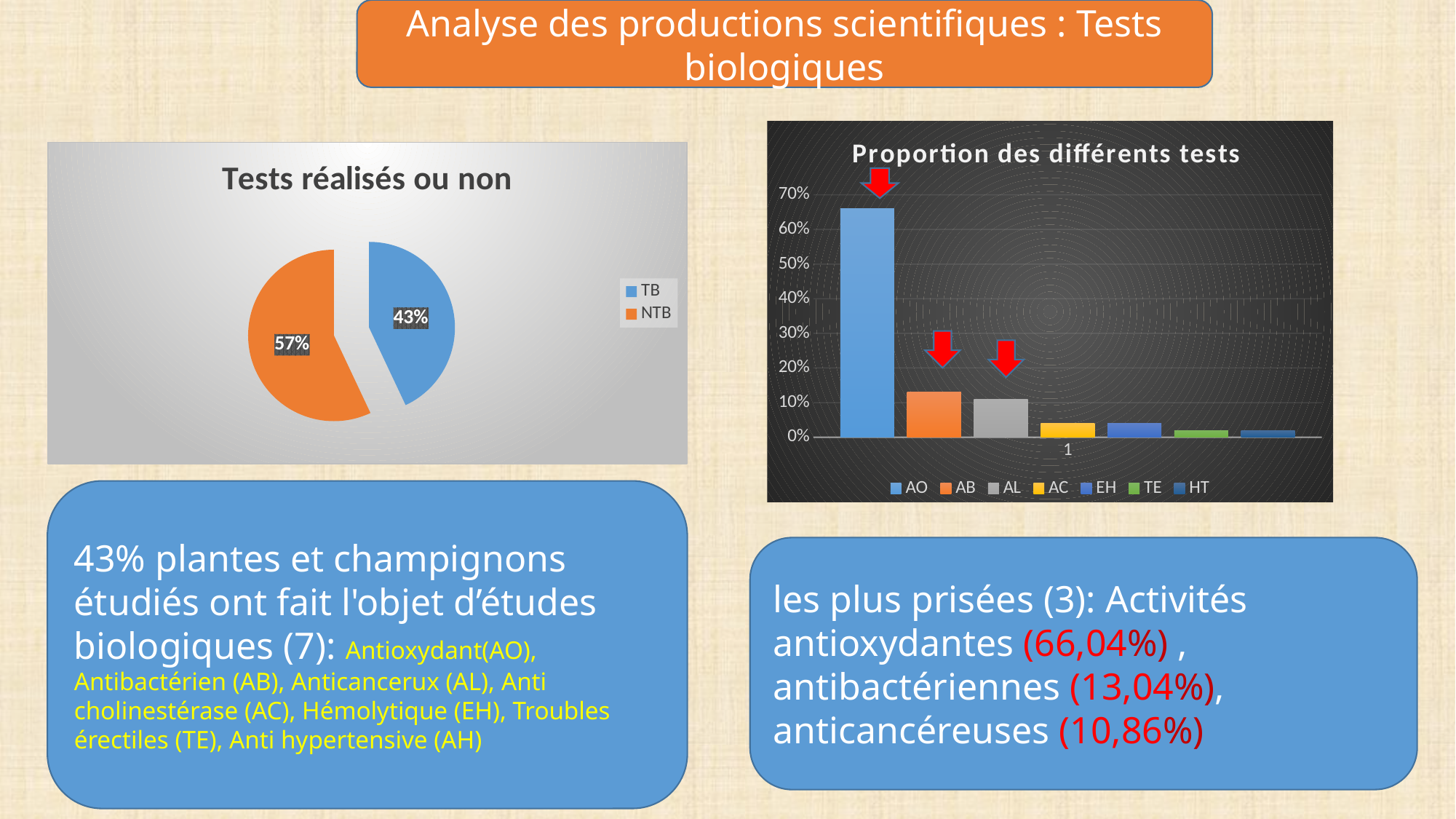
In the pie chart 'Tests réalisés ou non', how many slices does the pie have? 2 In the chart 'Proportion des différents tests', how many series does the legend list? 7 What kind of chart is 'Tests réalisés ou non'? pie chart In the pie chart 'Tests réalisés ou non', what percentage is shown for TB? 43% In the pie chart 'Tests réalisés ou non', what percentage is shown for NTB? 57% In the chart 'Proportion des différents tests', is the value for AO greater or less than 60%? greater In the chart 'Proportion des différents tests', which series has the highest value? AO What kind of chart is 'Proportion des différents tests'? bar chart In the pie chart 'Tests réalisés ou non', what is the difference in percentage points between NTB and TB? 14 In the pie chart 'Tests réalisés ou non', which slice is larger, TB or NTB? NTB In the chart 'Proportion des différents tests', is the value for AC greater or less than 10%? less In the chart 'Proportion des différents tests', is the value for AB greater or less than 10%? greater